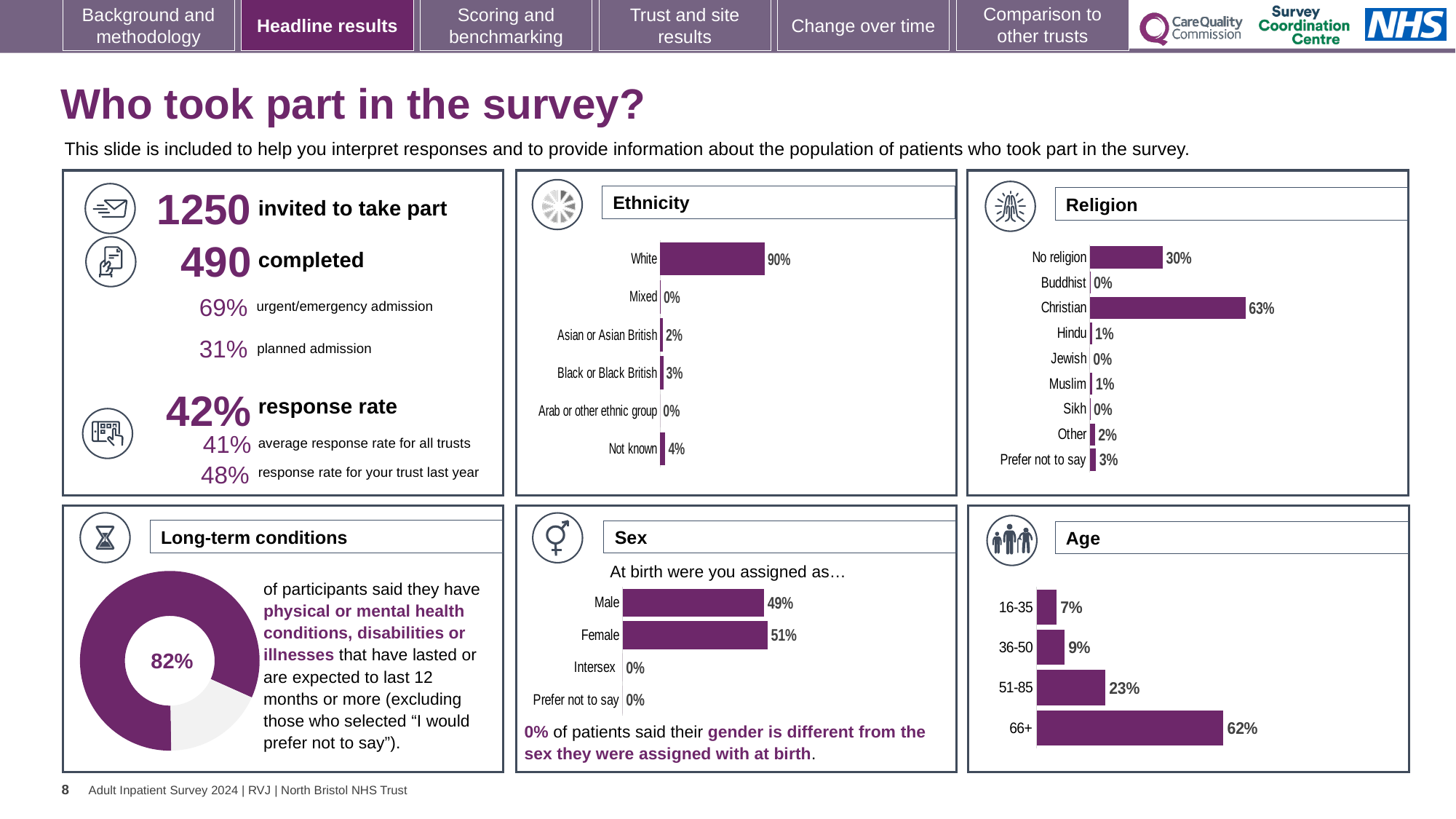
In the Ethnicity chart, how many categories are shown? 6 In the Age chart, what is the value for 66+? 62% In the Ethnicity chart, what is the value for White? 90% In the Age chart, which age group has the lowest value? 16-35 In the Sex chart, what is the value for Male? 49% What kind of chart is the Long-term conditions chart? doughnut chart In the Religion chart, what is the value for Christian? 63% In the Age chart, do the values rise or fall from 16-35 to 66+? rise In the Ethnicity chart, which category has the highest value? White In the Sex chart, which is larger, Male or Female? Female In the Religion chart, what is the difference between Christian and No religion? 33% In the Religion chart, how many categories are shown? 9